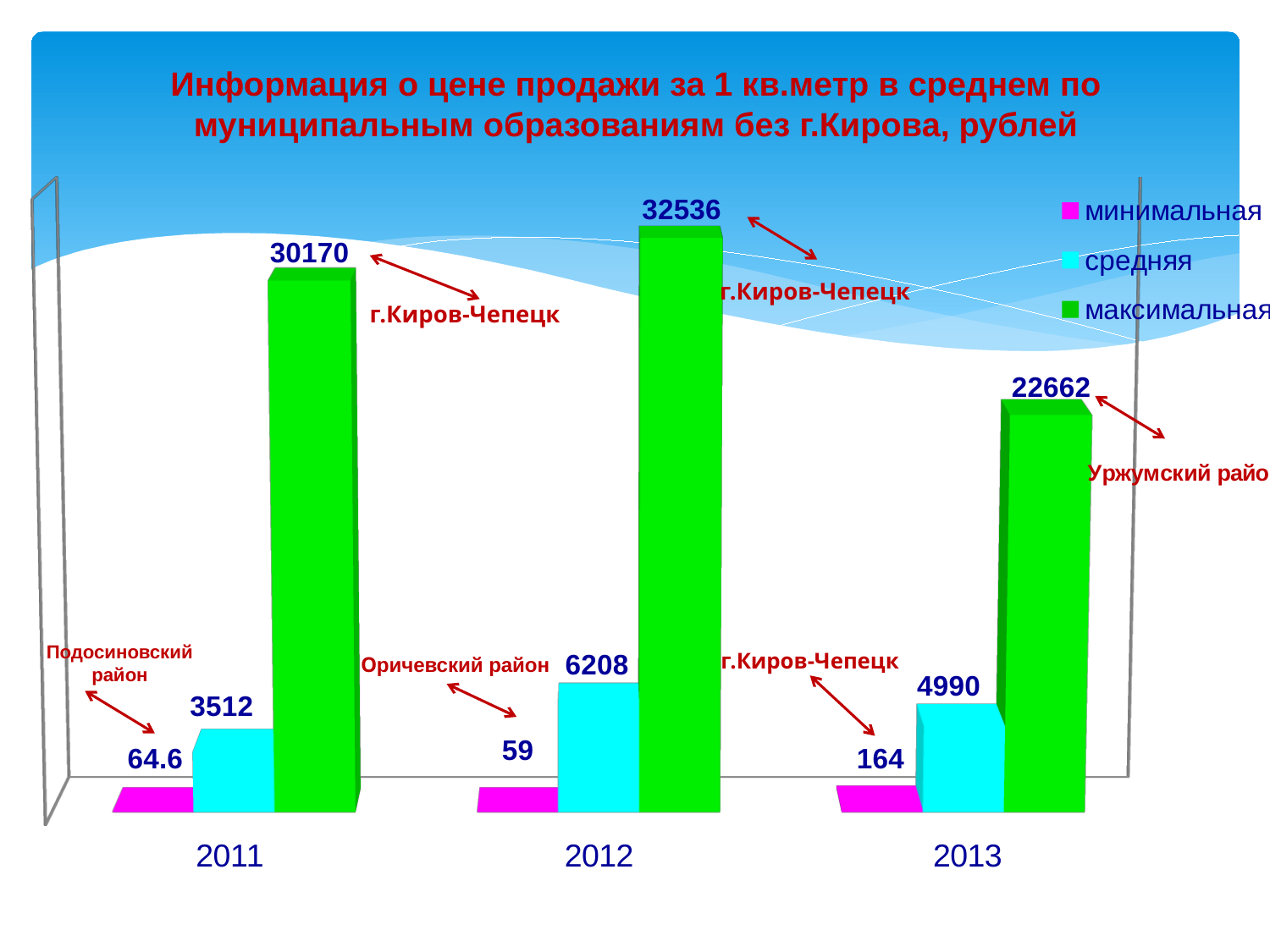
Which is larger, the средняя value for 2012 or for 2013? 2012 Which year has the lowest минимальная value? 2012 Which year has the highest максимальная value? 2012 How many series does the legend list? 3 Which colour represents the максимальная series in the legend? green What is the difference between the максимальная values for 2012 and 2013? 9874 What kind of chart is shown on the slide? bar chart What is the максимальная value for 2012? 32536 What is the difference between the средняя values for 2012 and 2011? 2696 What is the минимальная value for 2011? 64.6 What is the средняя value for 2013? 4990 How many years are shown on the x axis? 3